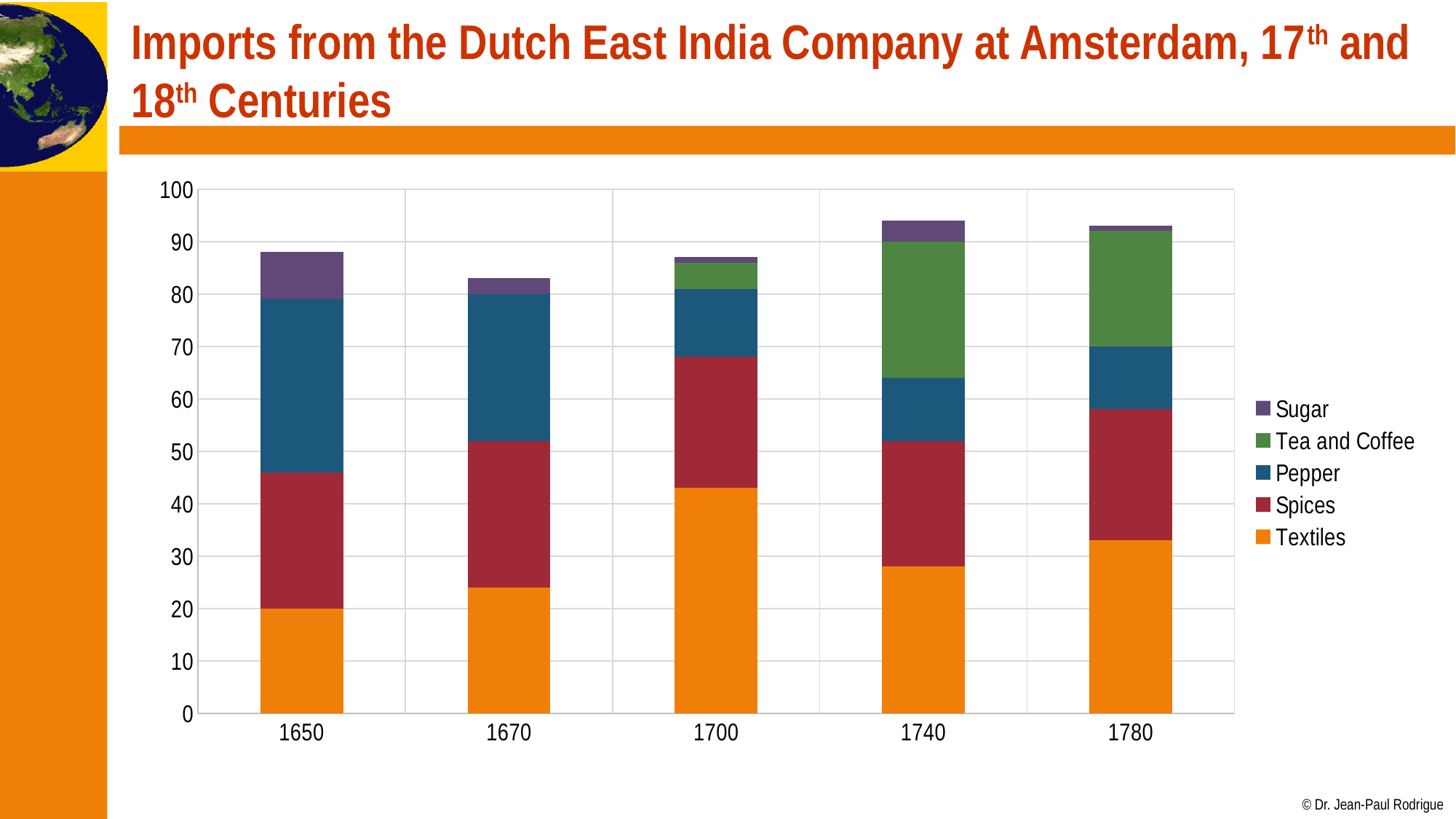
Which is larger, the Textiles value in 1650 or in 1700? 1700 Is the total stacked bar for 1670 greater or less than 90? less Does the Tea and Coffee value rise or fall from 1700 to 1740? rise Which is larger, the Pepper value in 1650 or in 1780? 1650 Is the total stacked bar for 1740 greater or less than 90? greater What kind of chart is shown on the slide? Stacked bar chart How many series does the legend list? 5 What is the value of Textiles in 1650? 20 Which year has the lowest total stacked bar? 1670 How many years are shown on the x axis? 5 Is the value for Textiles in 1700 greater or less than 40? greater Which series is shown in orange in the legend? Textiles